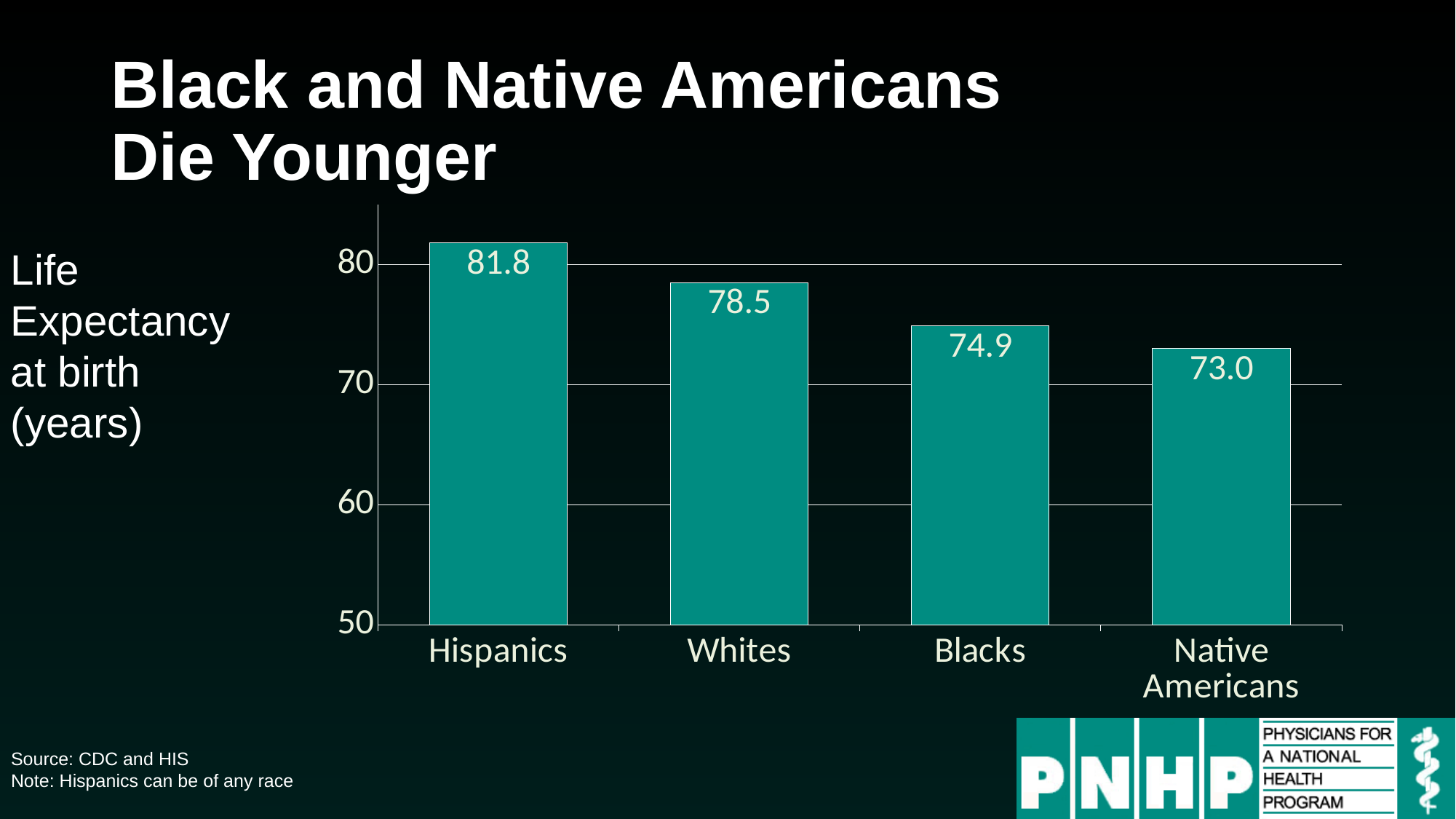
What is the life expectancy at birth for Blacks? 74.9 What is the life expectancy at birth for Hispanics? 81.8 What is the life expectancy at birth for Native Americans? 73.0 How many groups are shown in the chart? 4 What kind of chart is shown on the slide? Bar chart What is the life expectancy at birth for Whites? 78.5 Do the values rise or fall from left to right across the groups? Fall What is the difference in life expectancy between Hispanics and Native Americans? 8.8 Which group has the highest life expectancy at birth? Hispanics What is the difference in life expectancy between Whites and Blacks? 3.6 Which group has the lowest life expectancy at birth? Native Americans Which group has a higher life expectancy, Blacks or Whites? Whites